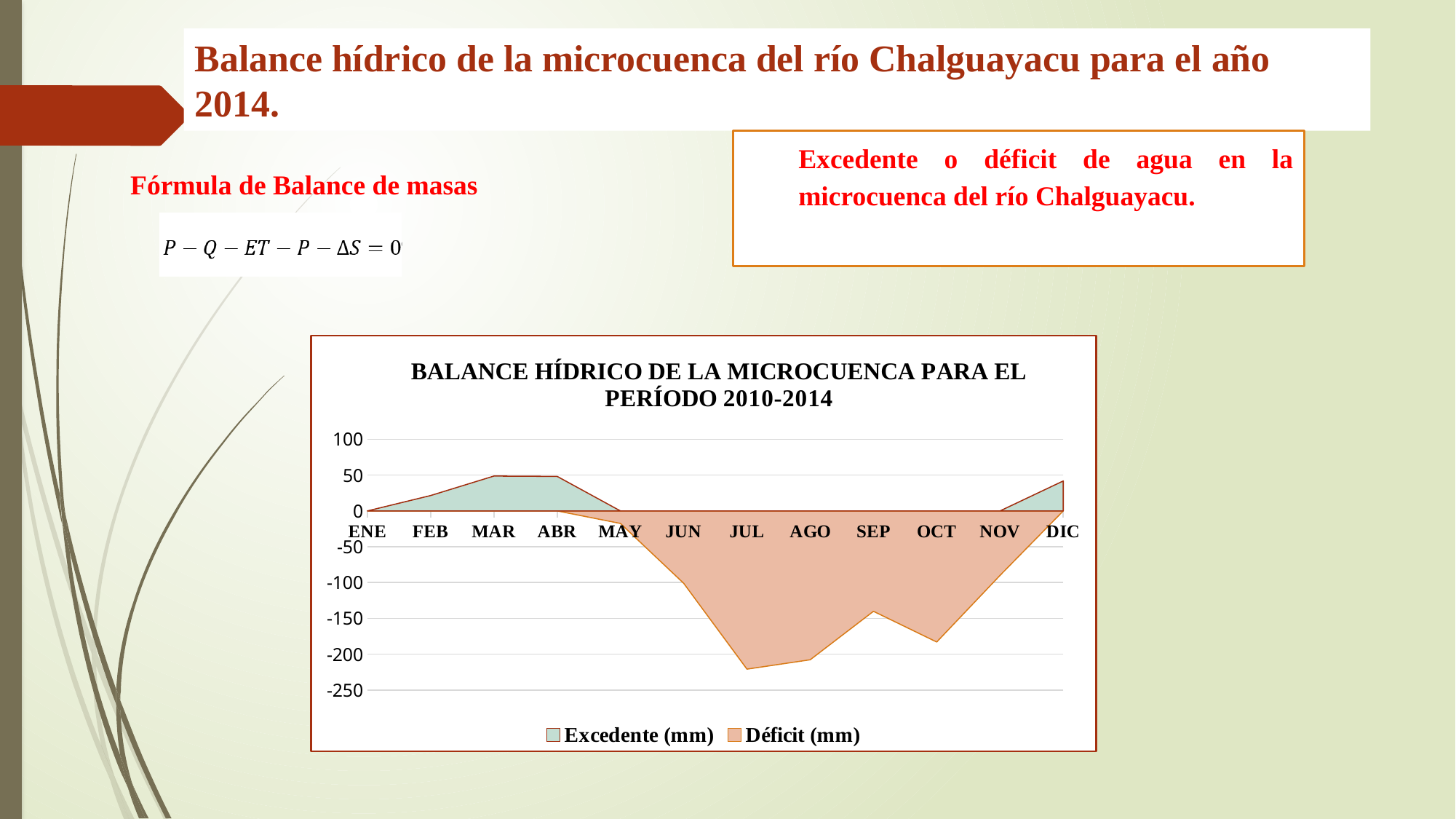
Do the values rise or fall from MAY to JUL? fall Which month has the lowest (most negative) value in the chart? JUL How many months are shown on the x axis of the chart? 12 What is the title of the chart? BALANCE HÍDRICO DE LA MICROCUENCA PARA EL PERÍODO 2010-2014 What kind of chart is shown on the slide? area chart What are the two series named in the chart legend? Excedente (mm) and Déficit (mm) Is the value for JUL greater or less than -200? less How many series does the chart legend list? 2 Is the value for MAR greater or less than 0? greater Is the value for DIC greater or less than 50? less Which month has the lower value, JUL or SEP? JUL